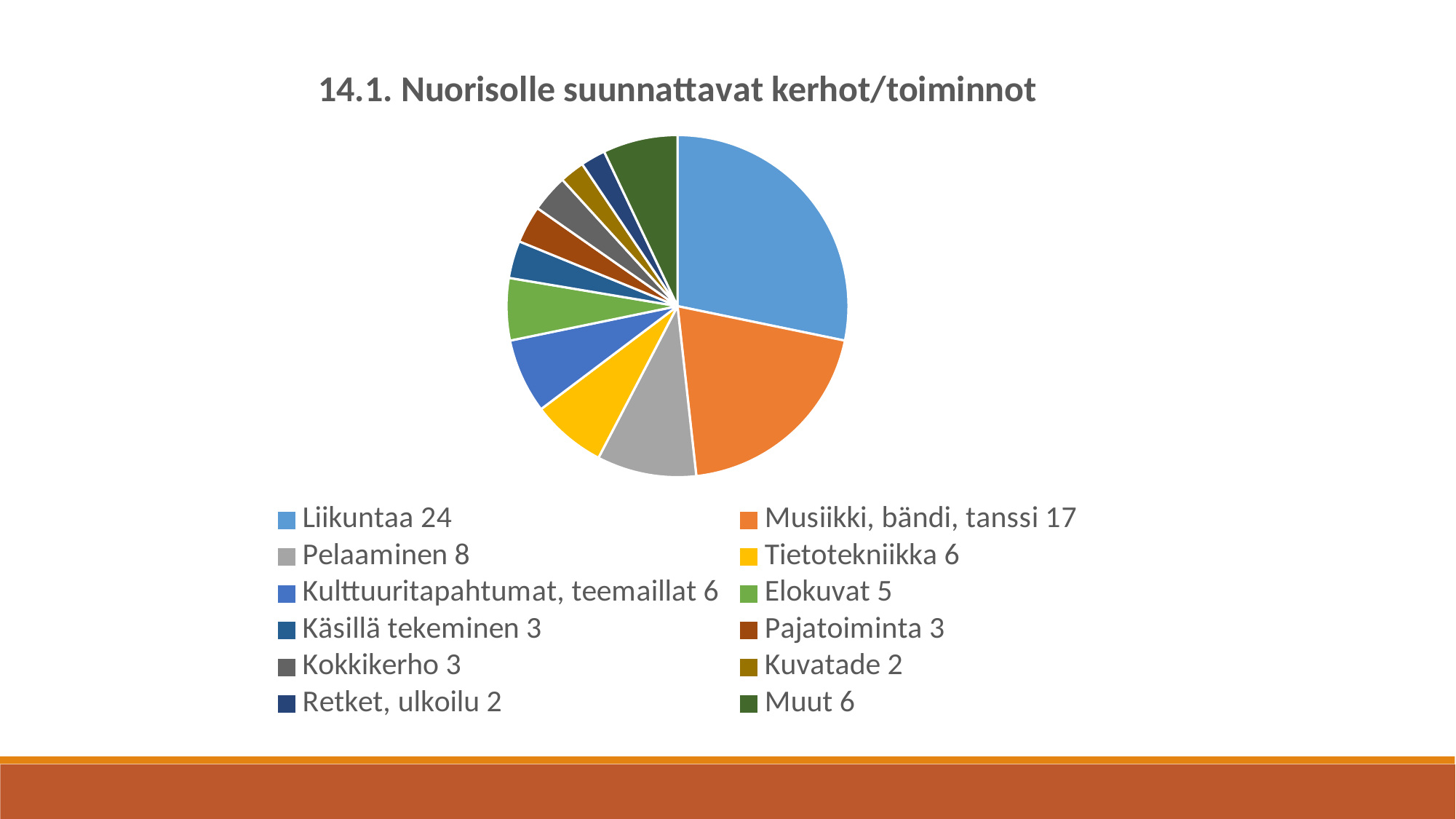
What is the value for Musiikki, bändi, tanssi? 17 Which is larger, the value for Pelaaminen or the value for Tietotekniikka? Pelaaminen What is the title of the chart? 14.1. Nuorisolle suunnattavat kerhot/toiminnot What is the value for Muut? 6 What is the difference between the values for Elokuvat and Kuvatade? 3 What is the value for Pelaaminen? 8 What kind of chart is shown on the slide? Pie chart What is the difference between the values for Liikuntaa and Musiikki, bändi, tanssi? 7 What is the value for Liikuntaa in the pie chart? 24 Which category has the largest slice of the pie? Liikuntaa How many categories does the pie chart show? 12 What is the value for Elokuvat? 5